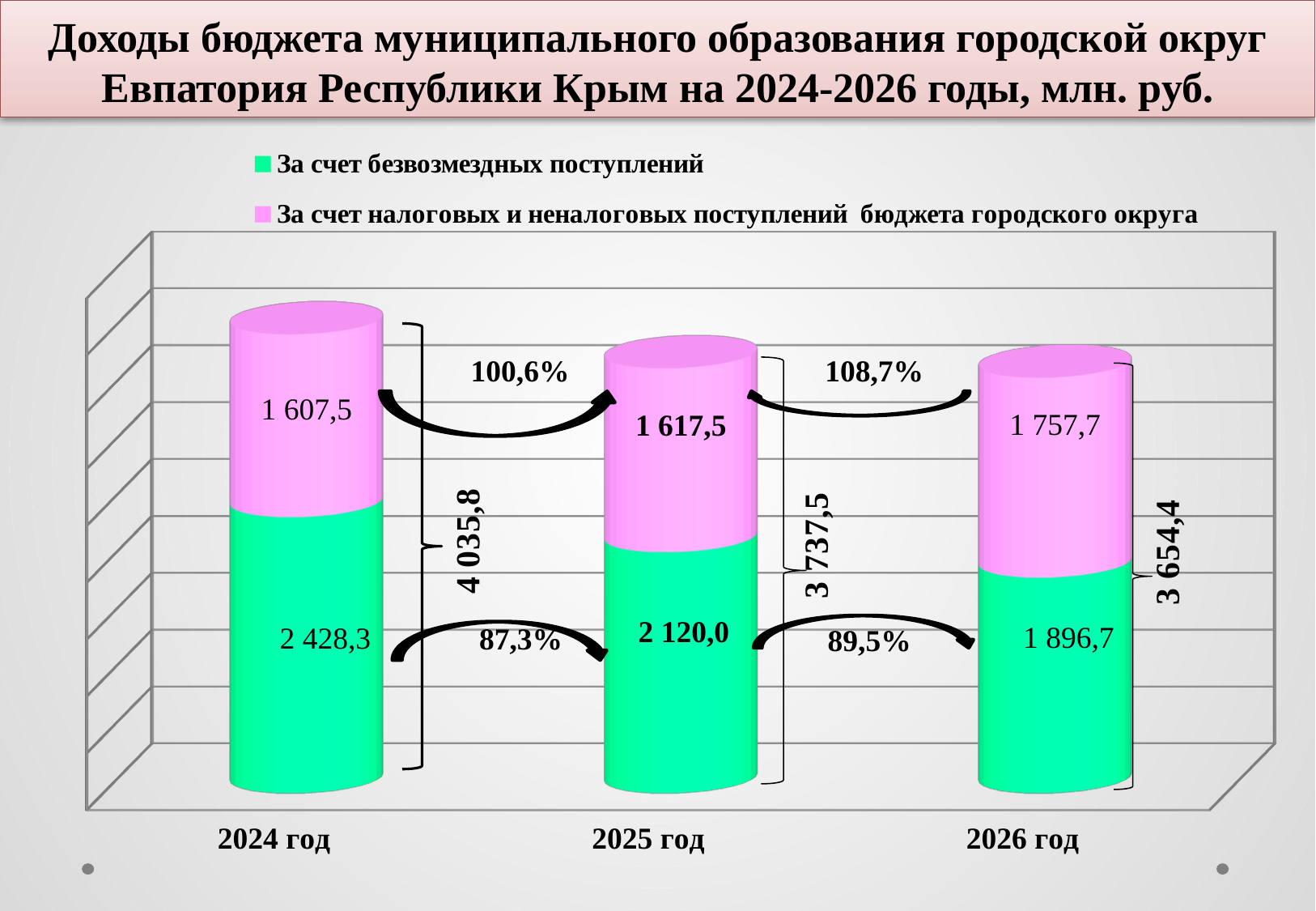
What is the value for 'За счет налоговых и неналоговых поступлений бюджета городского округа' in 2026 год? 1 757,7 What kind of chart is shown on the slide? Stacked bar chart Which is larger in 2026 год: 'За счет безвозмездных поступлений' or 'За счет налоговых и неналоговых поступлений бюджета городского округа'? За счет безвозмездных поступлений What is the value for 'За счет налоговых и неналоговых поступлений бюджета городского округа' in 2025 год? 1 617,5 Do the total budget revenues rise or fall from 2024 год to 2026 год? Fall What is the difference between 'За счет безвозмездных поступлений' and 'За счет налоговых и неналоговых поступлений бюджета городского округа' in 2024 год? 820,8 How many years (categories) are shown on the x axis? 3 What is the value for 'За счет безвозмездных поступлений' in 2024 год? 2 428,3 How many series does the legend list? 2 What is the total of the stacked bar for 2025 год? 3 737,5 Which year has the highest total budget revenue? 2024 год Which year has the lowest value for 'За счет безвозмездных поступлений'? 2026 год